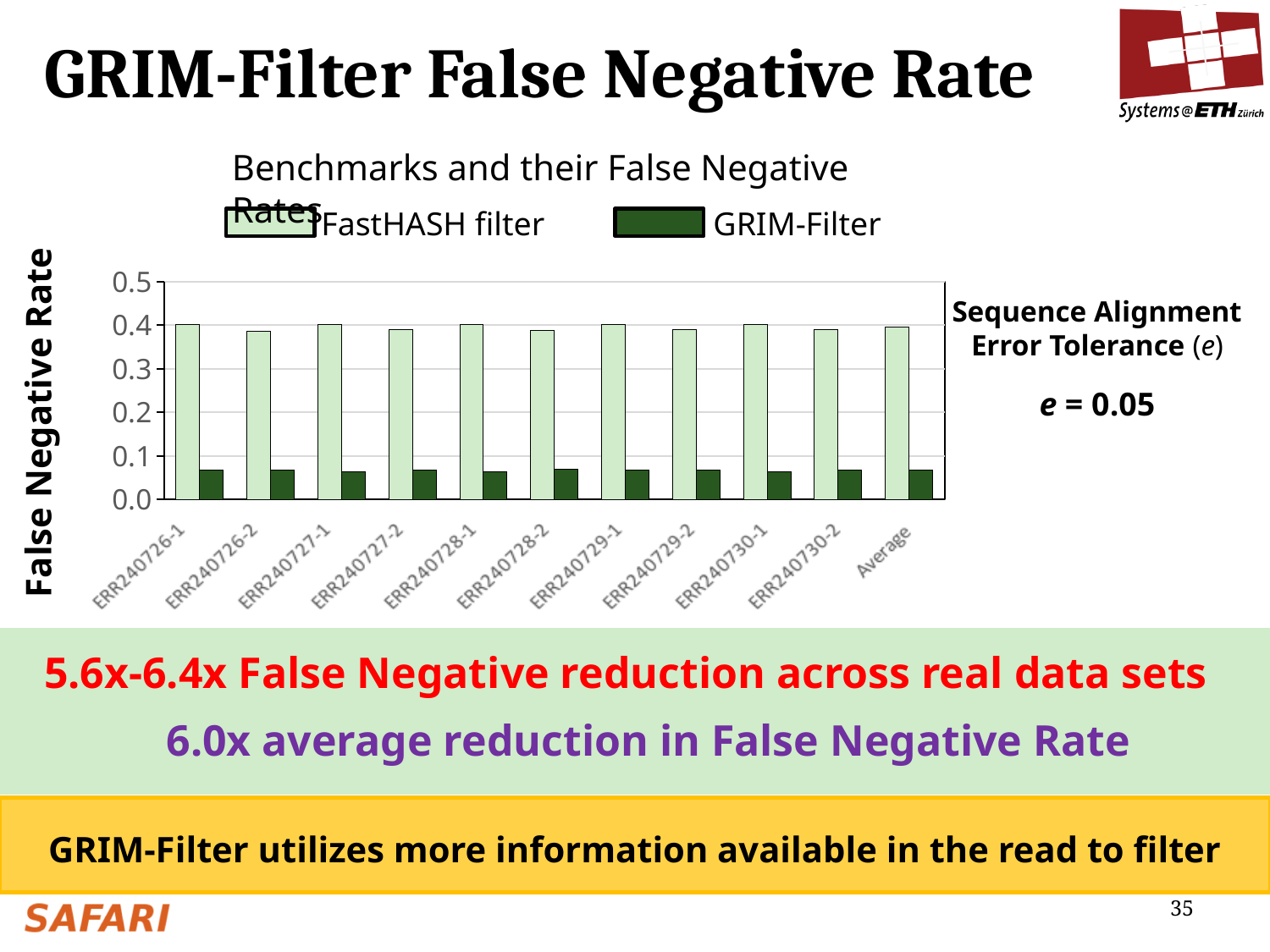
What kind of chart is shown on the slide? bar chart Is the GRIM-Filter value for ERR240728-1 greater or less than 0.2? less Is the FastHASH filter value for ERR240726-1 greater or less than 0.3? greater Is the FastHASH filter value for ERR240729-1 greater or less than 0.2? greater For the Average category, which series has the smaller value: FastHASH filter or GRIM-Filter? GRIM-Filter For ERR240727-1, which series has the larger value: FastHASH filter or GRIM-Filter? FastHASH filter What is the label of the chart's vertical axis? False Negative Rate How many series does the chart's legend list? 2 Which two series are listed in the chart's legend? FastHASH filter and GRIM-Filter How many categories are shown along the x axis of the chart? 11